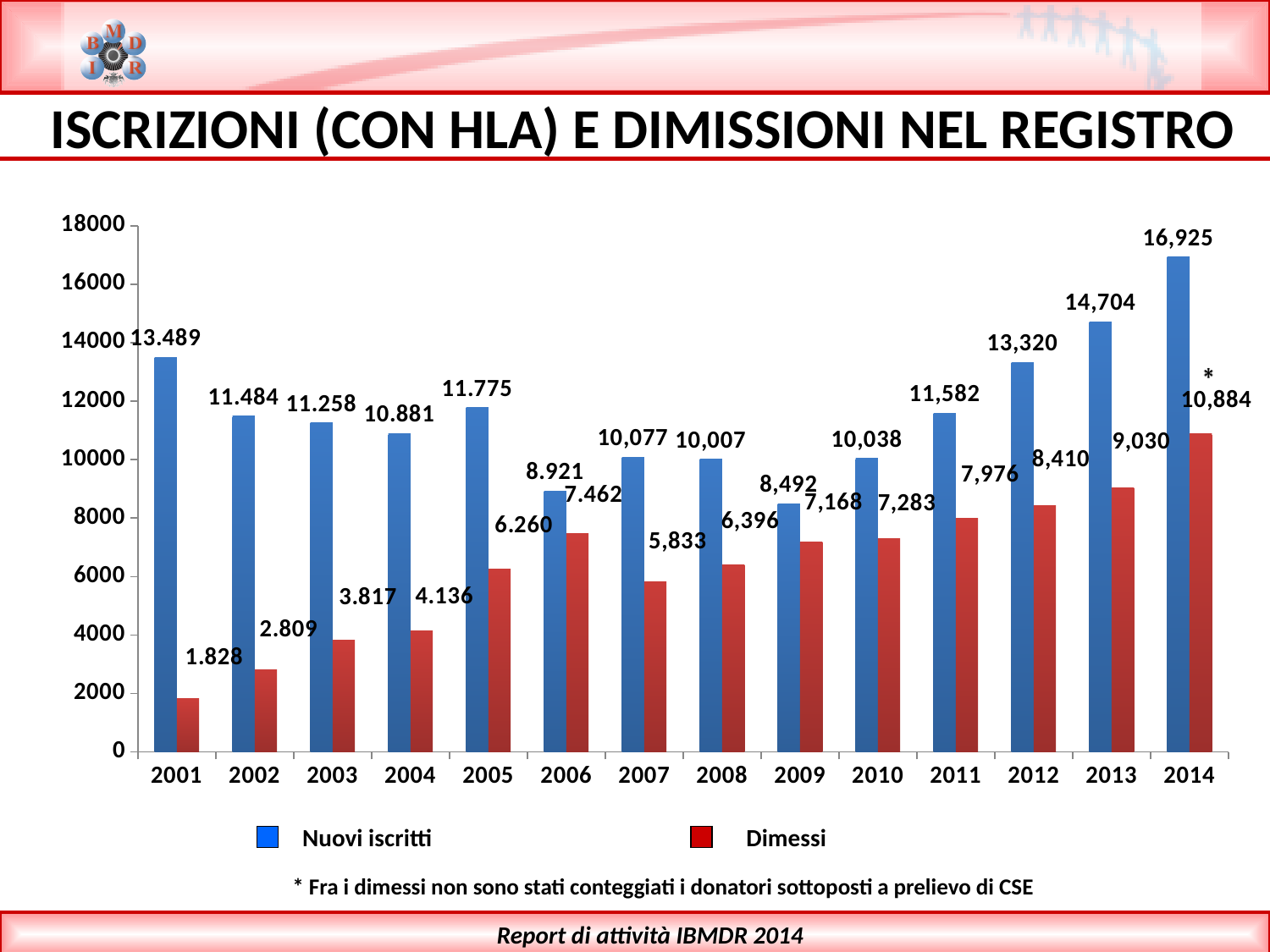
What is the difference between Nuovi iscritti and Dimessi in 2014? 6,041 In 2006, which is larger: Nuovi iscritti or Dimessi? Nuovi iscritti Do the Dimessi values rise or fall from 2010 to 2014? rise In which year is the Nuovi iscritti value highest? 2014 What is the value for Nuovi iscritti in 2005? 11.775 What is the value for Dimessi in 2012? 8,410 What is the value for Nuovi iscritti in 2014? 16,925 What is the value for Dimessi in 2001? 1.828 How many series does the legend list? 2 In which year is the Dimessi value lowest? 2001 How many years are shown on the x axis? 14 In which year is the Nuovi iscritti value lowest? 2009